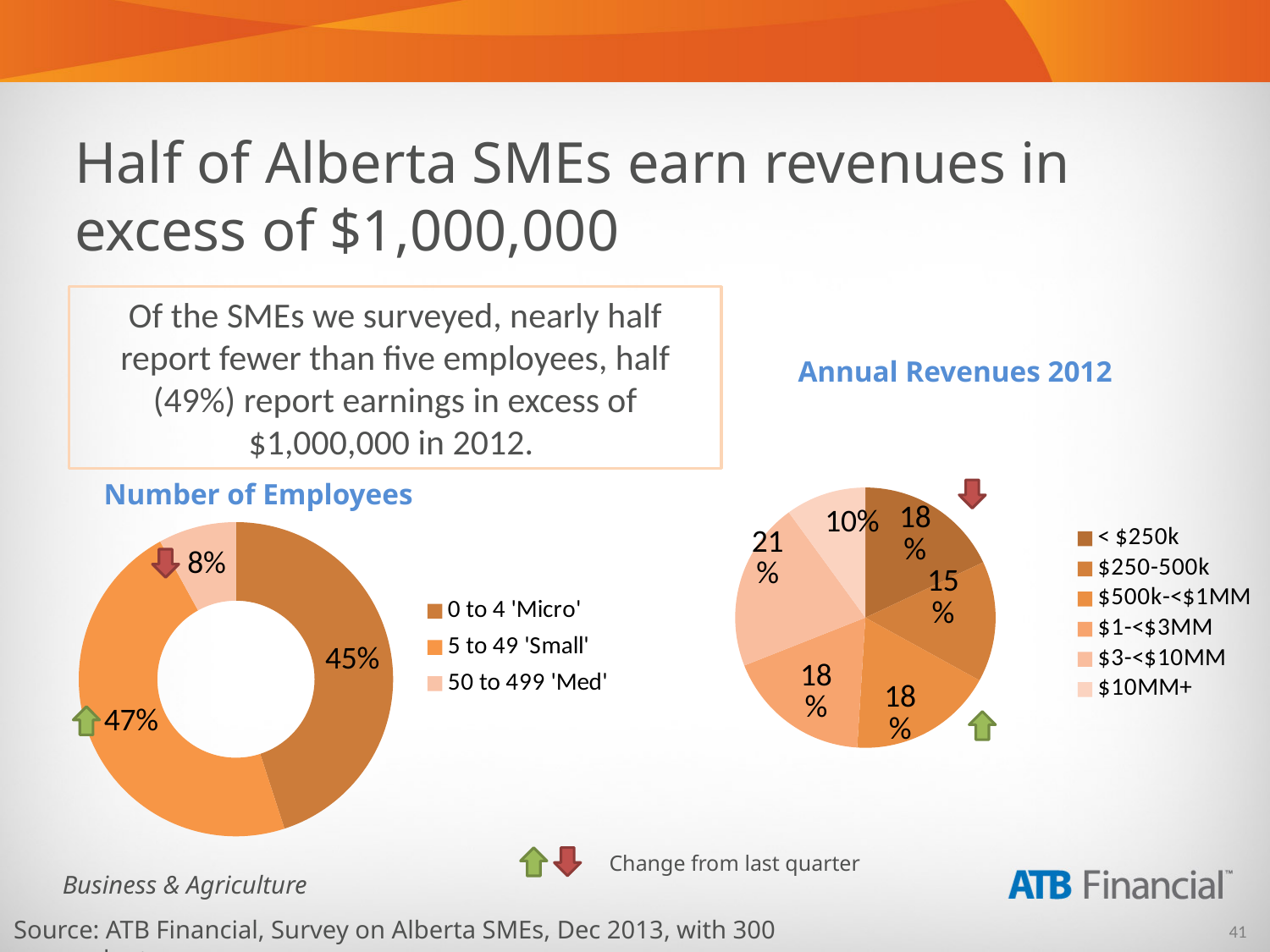
In the Number of Employees chart, what share of SMEs have 0 to 4 'Micro' employees? 45% In the Annual Revenues 2012 chart, how many revenue categories are shown? 6 What kind of chart is the Number of Employees chart? Doughnut chart In the Number of Employees chart, how many categories does the legend list? 3 In the Annual Revenues 2012 chart, which is larger: the share for $250-500k or the share for $10MM+? $250-500k In the Number of Employees chart, what is the difference between the 5 to 49 'Small' share and the 0 to 4 'Micro' share? 2% In the Annual Revenues 2012 chart, which revenue category has the smallest share? $10MM+ In the Number of Employees chart, what share of SMEs have 50 to 499 'Med' employees? 8% In the Annual Revenues 2012 chart, which revenue category has the largest share? $3-<$10MM In the Annual Revenues 2012 chart, what share of SMEs earn $3-<$10MM? 21% In the Annual Revenues 2012 chart, what share of SMEs earn $250-500k? 15% In the Number of Employees chart, which category has the largest share? 5 to 49 'Small'